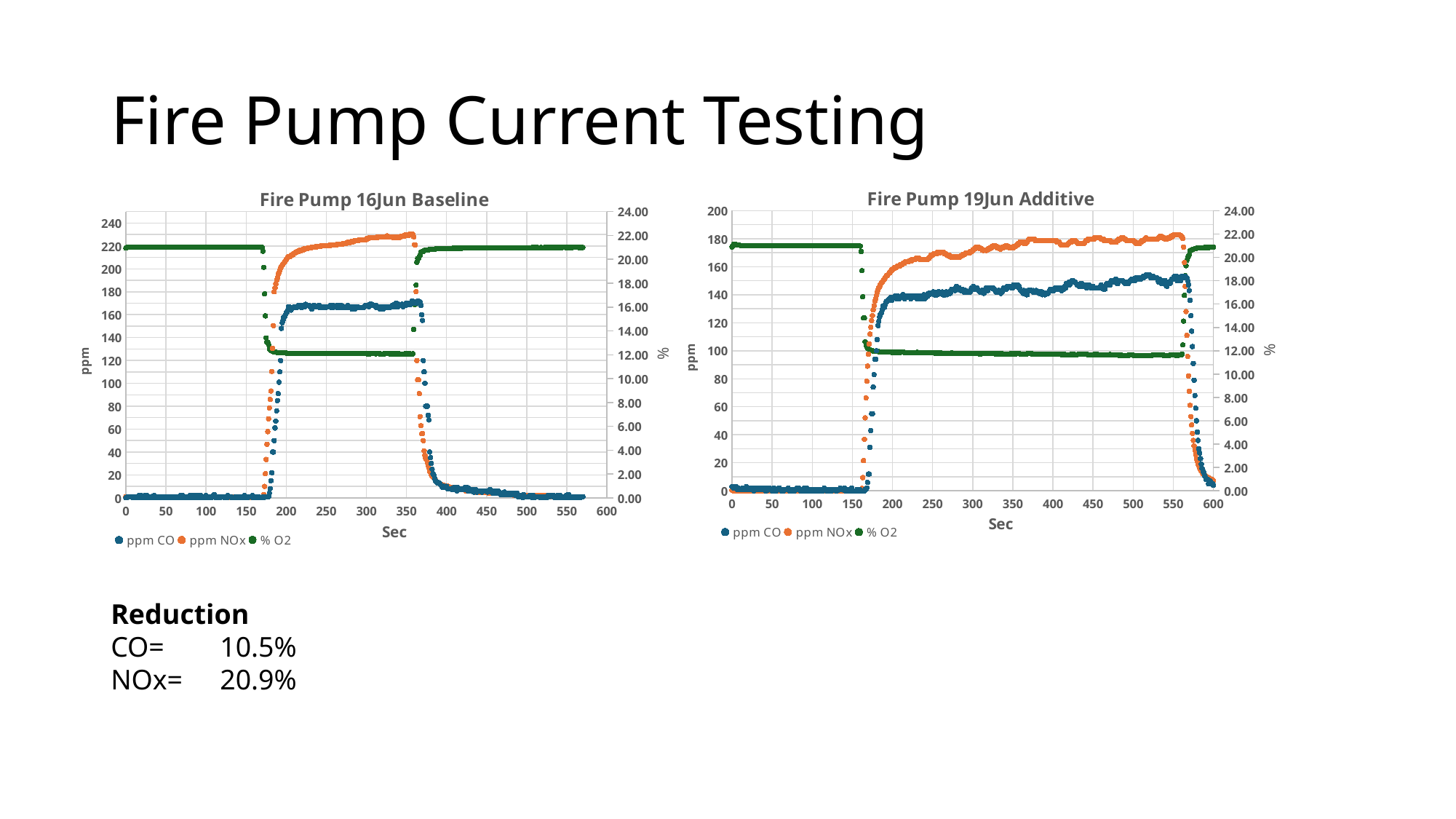
What kind of chart is the 'Fire Pump 16Jun Baseline' chart? scatter chart What are the legend entries on the 'Fire Pump 16Jun Baseline' chart? ppm CO, ppm NOx, % O2 On the 'Fire Pump 16Jun Baseline' chart, is the % O2 value at 100 sec greater or less than 20.00? greater On the 'Fire Pump 19Jun Additive' chart, is the % O2 value at 300 sec greater or less than 14.00? less On the 'Fire Pump 19Jun Additive' chart, is the ppm CO value at 300 sec greater or less than 160? less What is the x-axis label on the 'Fire Pump 19Jun Additive' chart? Sec How many series does the legend of the 'Fire Pump 19Jun Additive' chart list? 3 On the 'Fire Pump 16Jun Baseline' chart, at 300 sec, which series is higher: ppm CO or ppm NOx? ppm NOx On the 'Fire Pump 19Jun Additive' chart, does the ppm NOx series rise or fall between 200 sec and 550 sec? rise